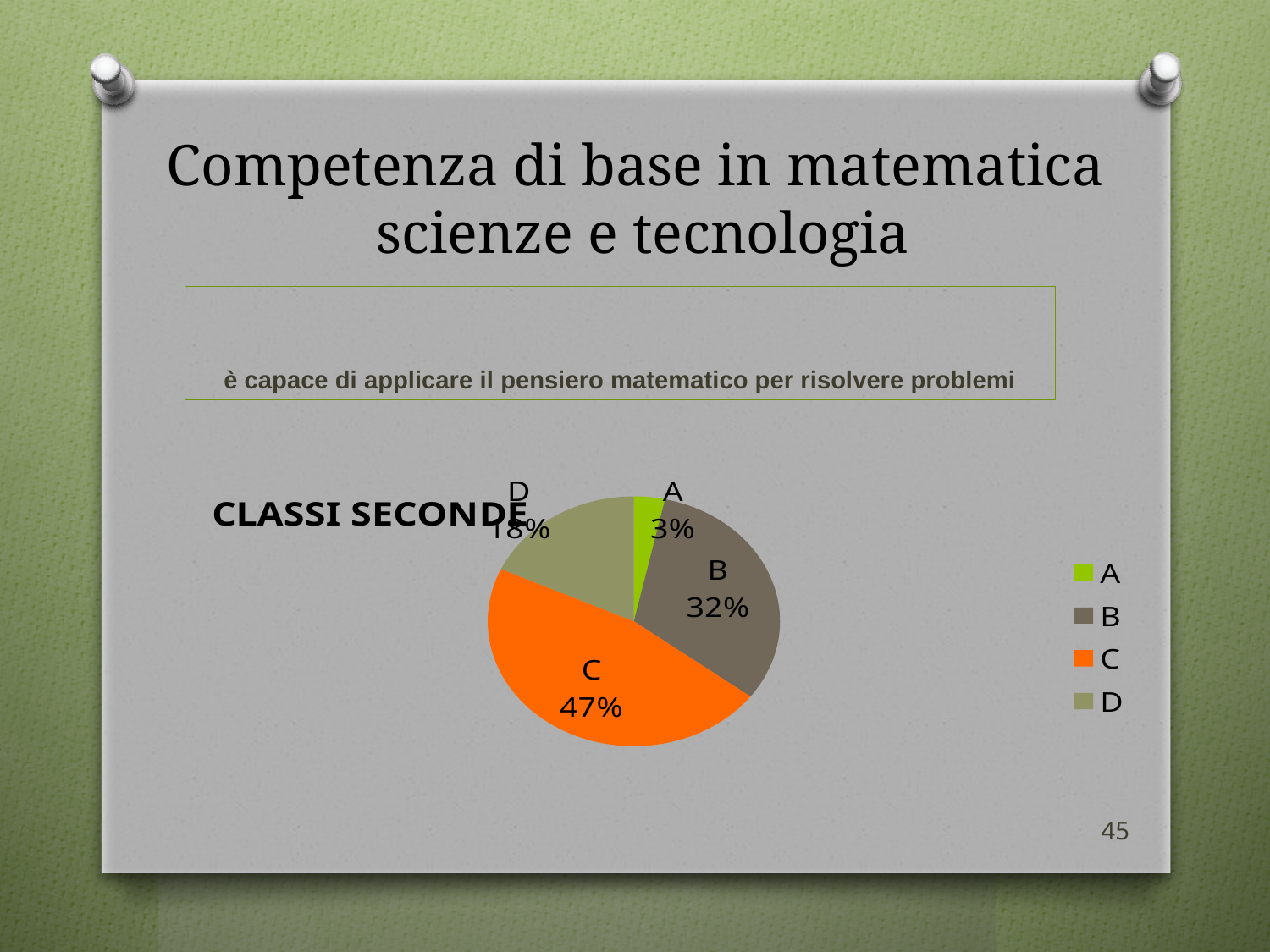
What colour is used for category C in the pie chart? orange What is the difference in percentage points between slice C and slice B? 15 What percentage does slice A represent in the pie chart? 3% How many categories are shown in the pie chart? 4 What type of chart is shown on the slide? pie chart What percentage does slice C represent in the pie chart? 47% What percentage does slice B represent in the pie chart? 32% Which category has the largest share of the pie chart? C Which is larger, the share for B or the share for D? B Which category has the smallest share of the pie chart? A What percentage does slice D represent in the pie chart? 18% How many entries does the legend list? 4